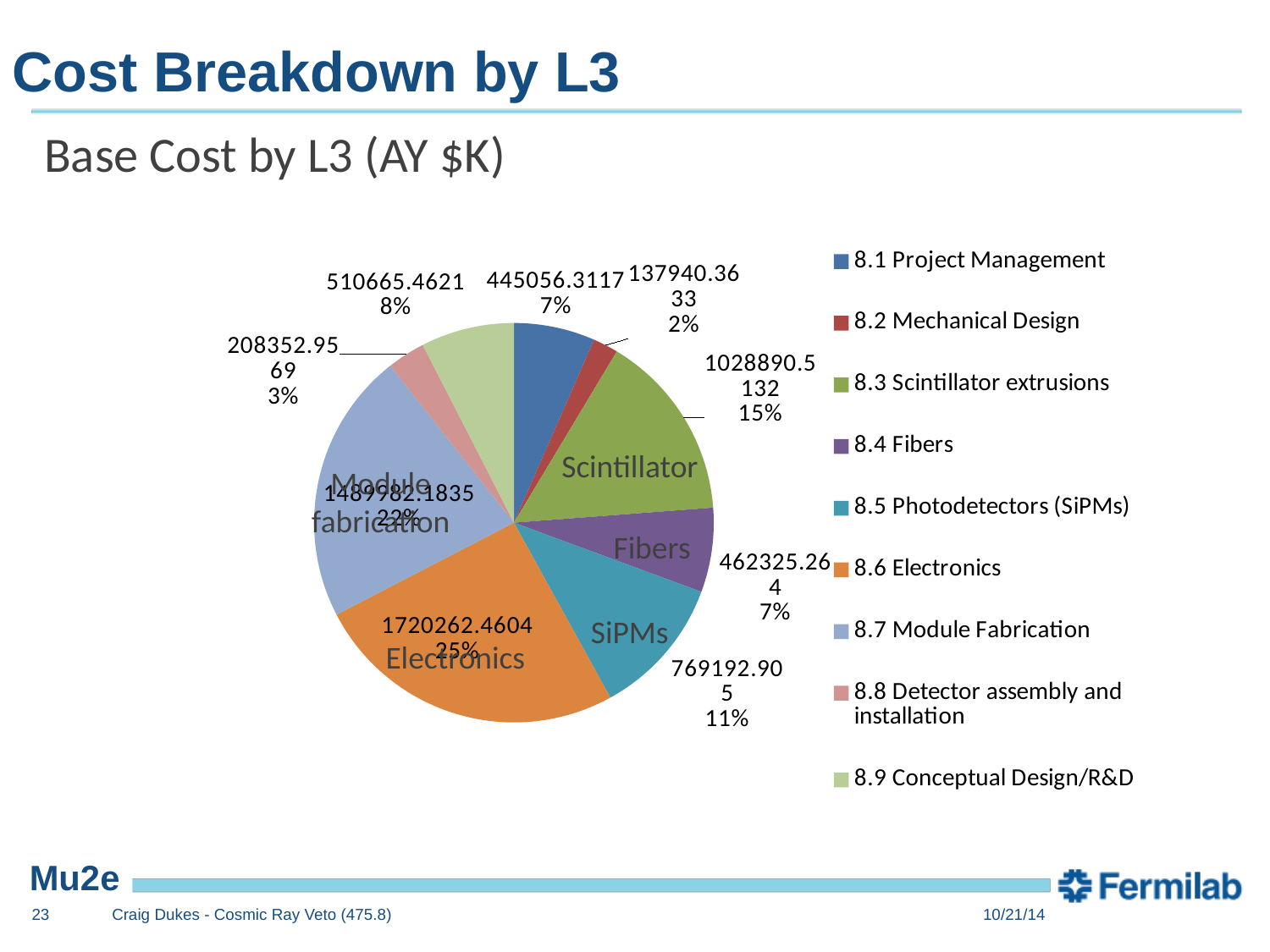
What is the difference in percentage share between Electronics (25%) and Module Fabrication (22%)? 3% What share of the pie does Scintillator extrusions account for? 15% Which category has the smallest slice of the pie? 8.2 Mechanical Design How many categories does the legend of the pie chart list? 9 What share of the pie does Electronics account for? 25% Which category has the largest slice of the pie? 8.6 Electronics What is the value shown for 8.6 Electronics? 1720262.4604 What kind of chart is shown on the slide? pie chart What is the value shown for 8.9 Conceptual Design/R&D? 510665.4621 What is the value shown for 8.1 Project Management? 445056.3117 Which is larger, the slice for Module Fabrication or the slice for SiPMs? Module Fabrication What is the title of the chart? Base Cost by L3 (AY $K)